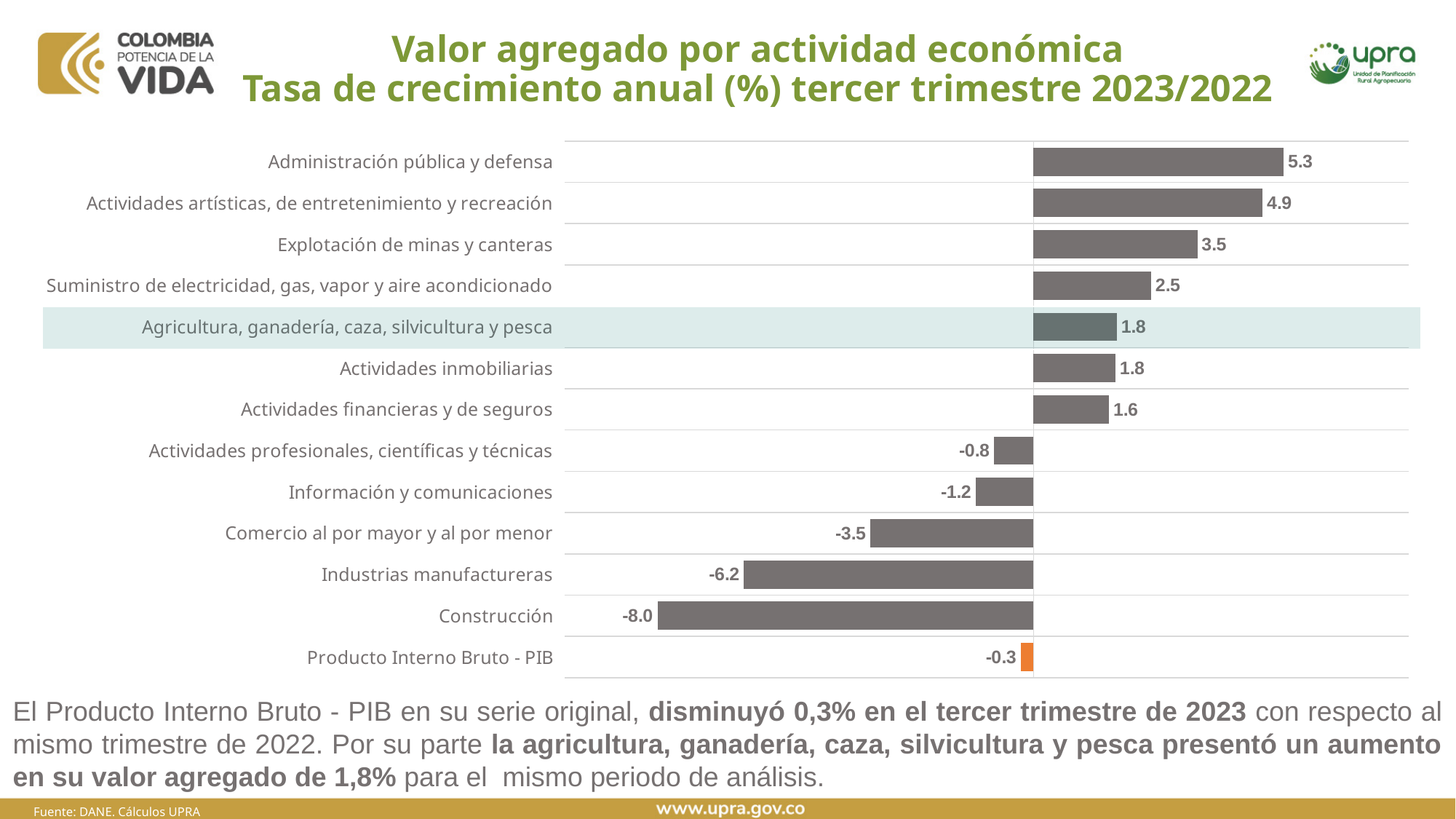
How many categories are plotted on the chart? 13 Which has a larger value, Industrias manufactureras or Comercio al por mayor y al por menor? Comercio al por mayor y al por menor What is the difference between the values for Administración pública y defensa and Explotación de minas y canteras? 1.8 What value is shown for Agricultura, ganadería, caza, silvicultura y pesca? 1.8 Which activity has the lowest value on the chart? Construcción What is the annual growth rate shown for Administración pública y defensa? 5.3 What is the difference between the values for Industrias manufactureras and Construcción? 1.8 Which bar on the chart is coloured orange? Producto Interno Bruto - PIB What type of chart is shown on the slide? Bar chart What is the value for Producto Interno Bruto - PIB? -0.3 Which activity has the highest growth rate on the chart? Administración pública y defensa What value is shown for Construcción? -8.0